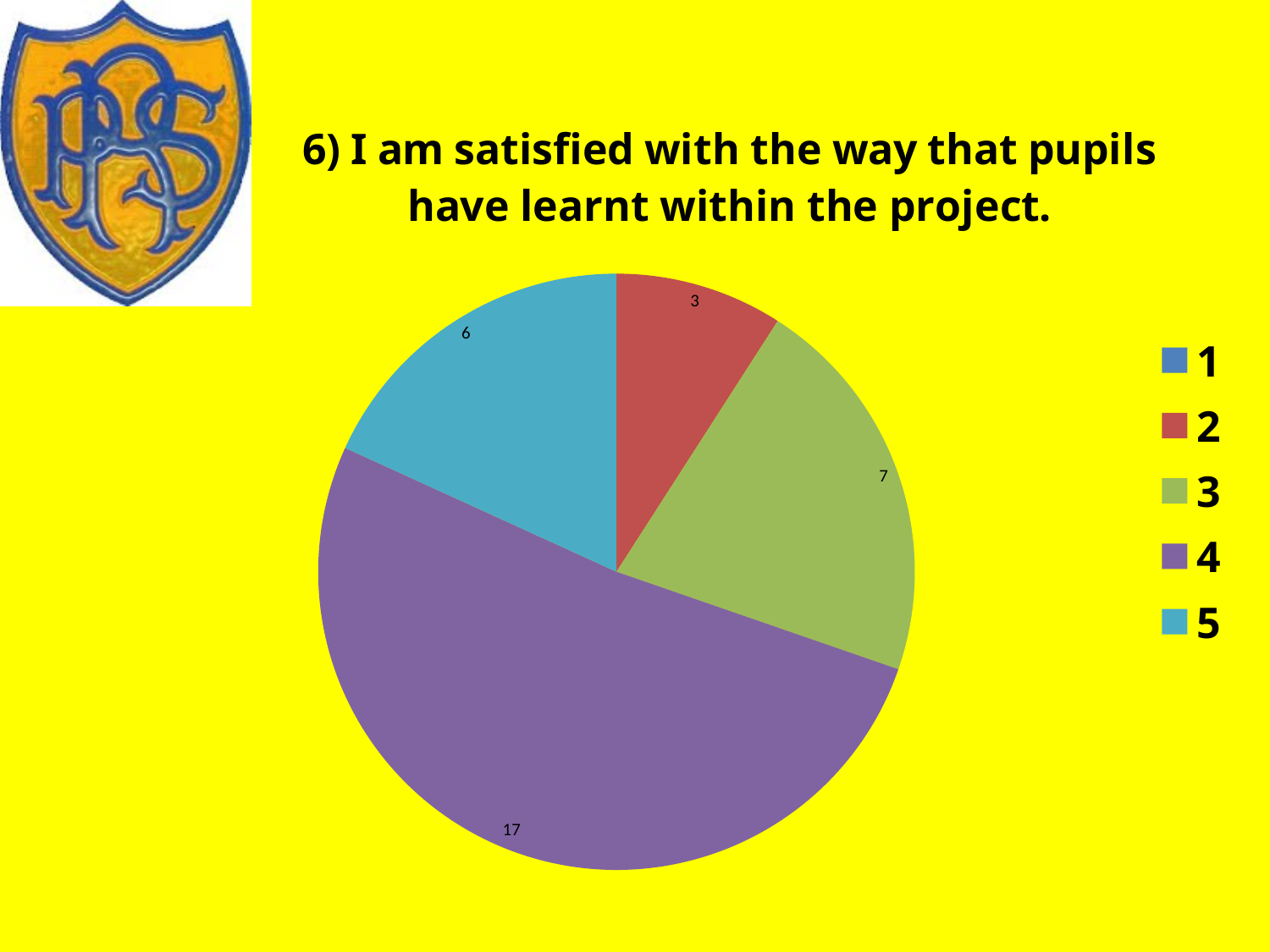
Which labelled slice has the smallest value? 2 Which category has the largest slice of the pie? 4 What is the value of the slice for category 2? 3 Which is larger, the slice for category 3 or the slice for category 5? 3 What type of chart is shown on the slide? pie chart What is the value of the slice for category 3? 7 What is the value of the slice for category 5? 6 What is the difference between the values for category 4 and category 3? 10 How many entries does the legend list? 5 What is the difference between the values for category 5 and category 2? 3 What is the value of the slice for category 4? 17 What is the title of the chart? 6) I am satisfied with the way that pupils have learnt within the project.